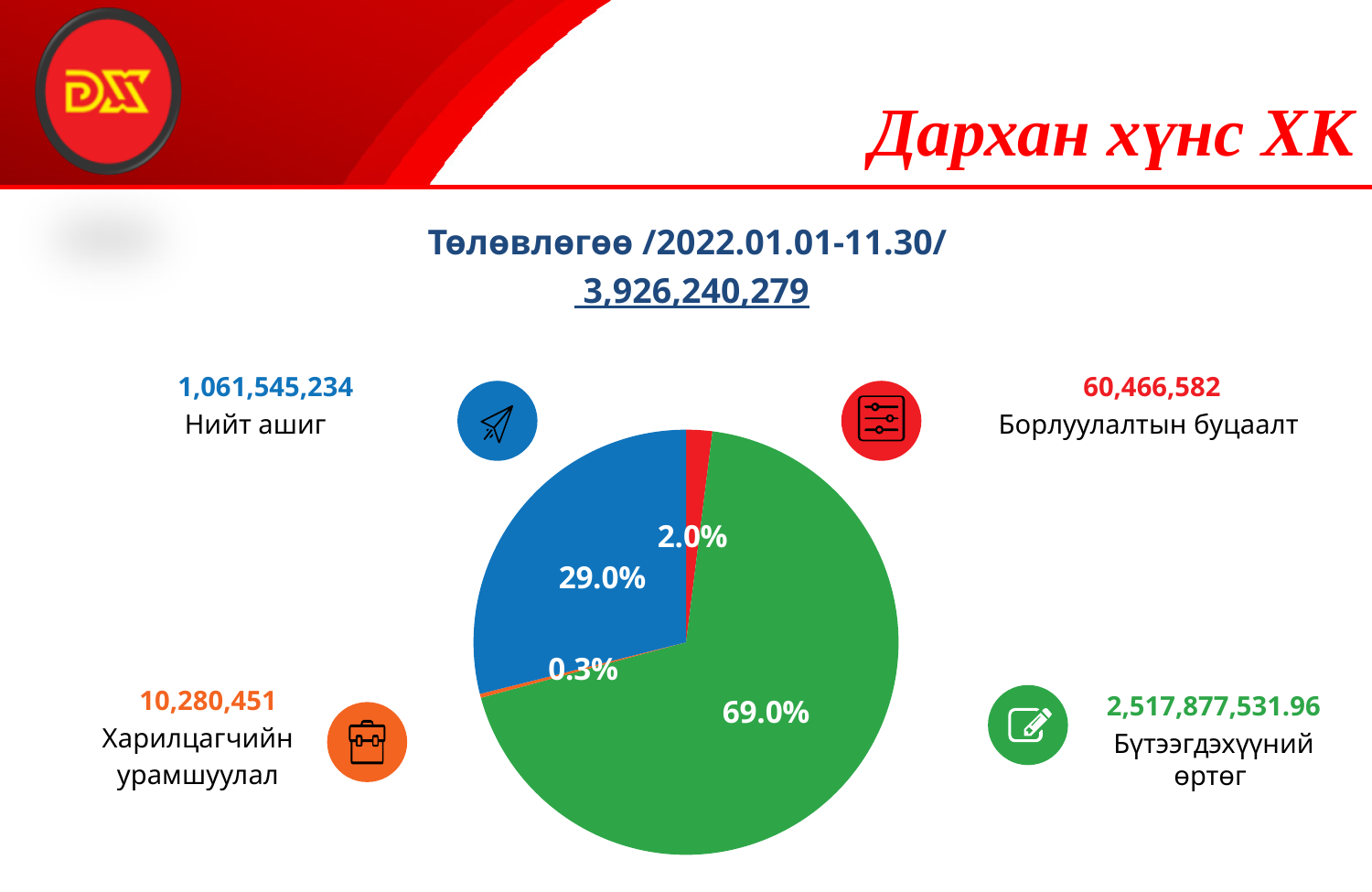
Which is larger, the share for Нийт ашиг or the share for Борлуулалтын буцаалт? Нийт ашиг What is the value shown for Нийт ашиг? 1,061,545,234 What percentage share does the green slice (Бүтээгдэхүүний өртөг) have in the pie chart? 69.0% What percentage share does the blue slice (Нийт ашиг) have in the pie chart? 29.0% Which category has the largest slice in the pie chart? Бүтээгдэхүүний өртөг What is the value shown for Бүтээгдэхүүний өртөг? 2,517,877,531.96 What is the difference in percentage points between the green slice (69.0%) and the blue slice (29.0%)? 40.0% Which category has the smallest slice in the pie chart? Харилцагчийн урамшуулал What kind of chart is shown on the slide? Pie chart What percentage share does the orange slice (Харилцагчийн урамшуулал) have in the pie chart? 0.3% How many slices does the pie chart have? 4